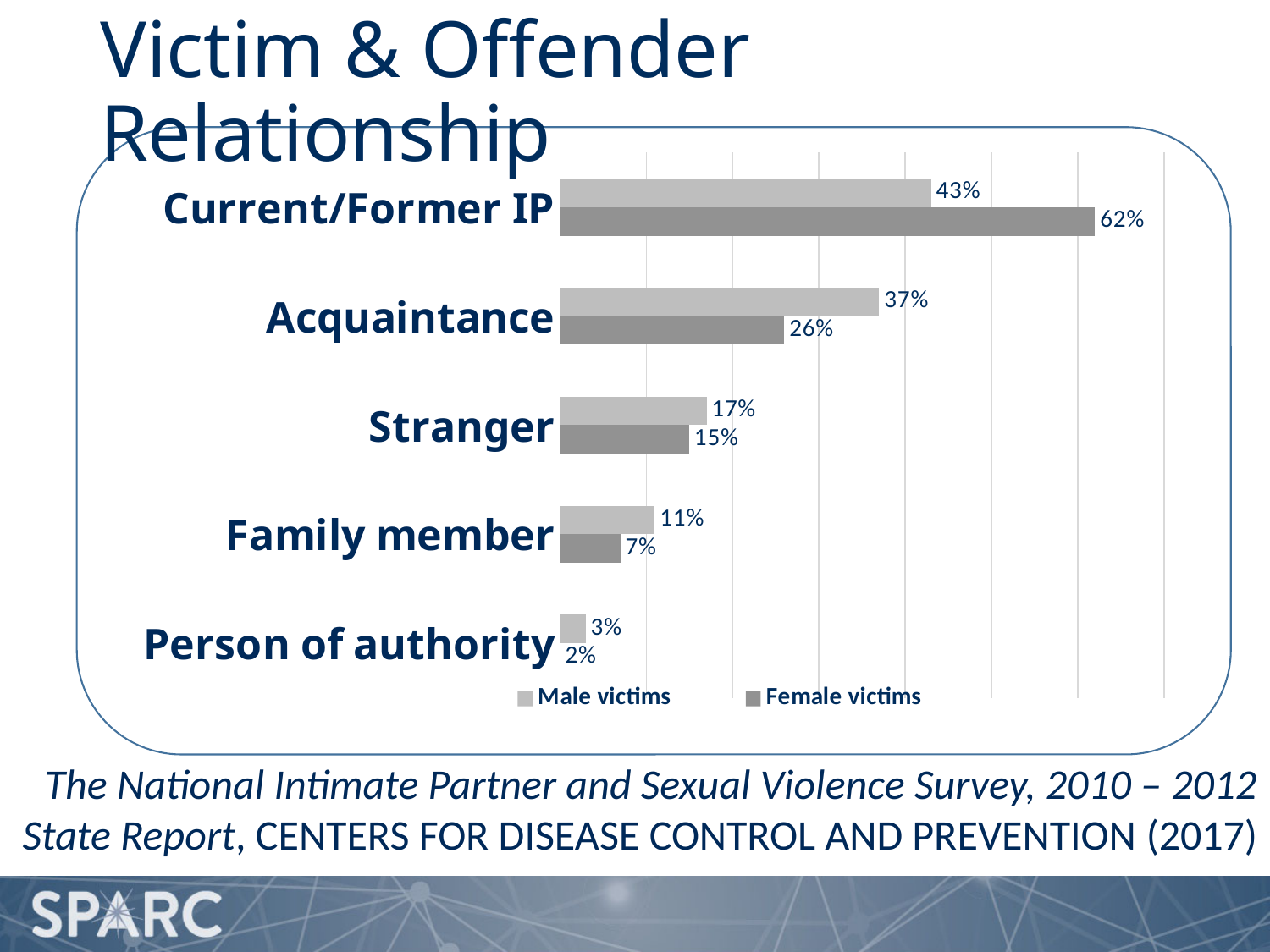
What is the value for Female victims in the Current/Former IP category? 62% What are the two series named in the legend? Male victims and Female victims What is the difference between the Male victims and Female victims values for Acquaintance? 11% What kind of chart is shown on the slide? Bar chart What is the difference between the Female victims and Male victims values for Current/Former IP? 19% Which category has the lowest value for Male victims? Person of authority For the Stranger category, which is larger: the Male victims value or the Female victims value? Male victims How many series does the legend list? 2 What is the value for Male victims in the Acquaintance category? 37% What is the value for Female victims in the Family member category? 7% Which category has the highest value for Female victims? Current/Former IP How many relationship categories are shown in the chart? 5